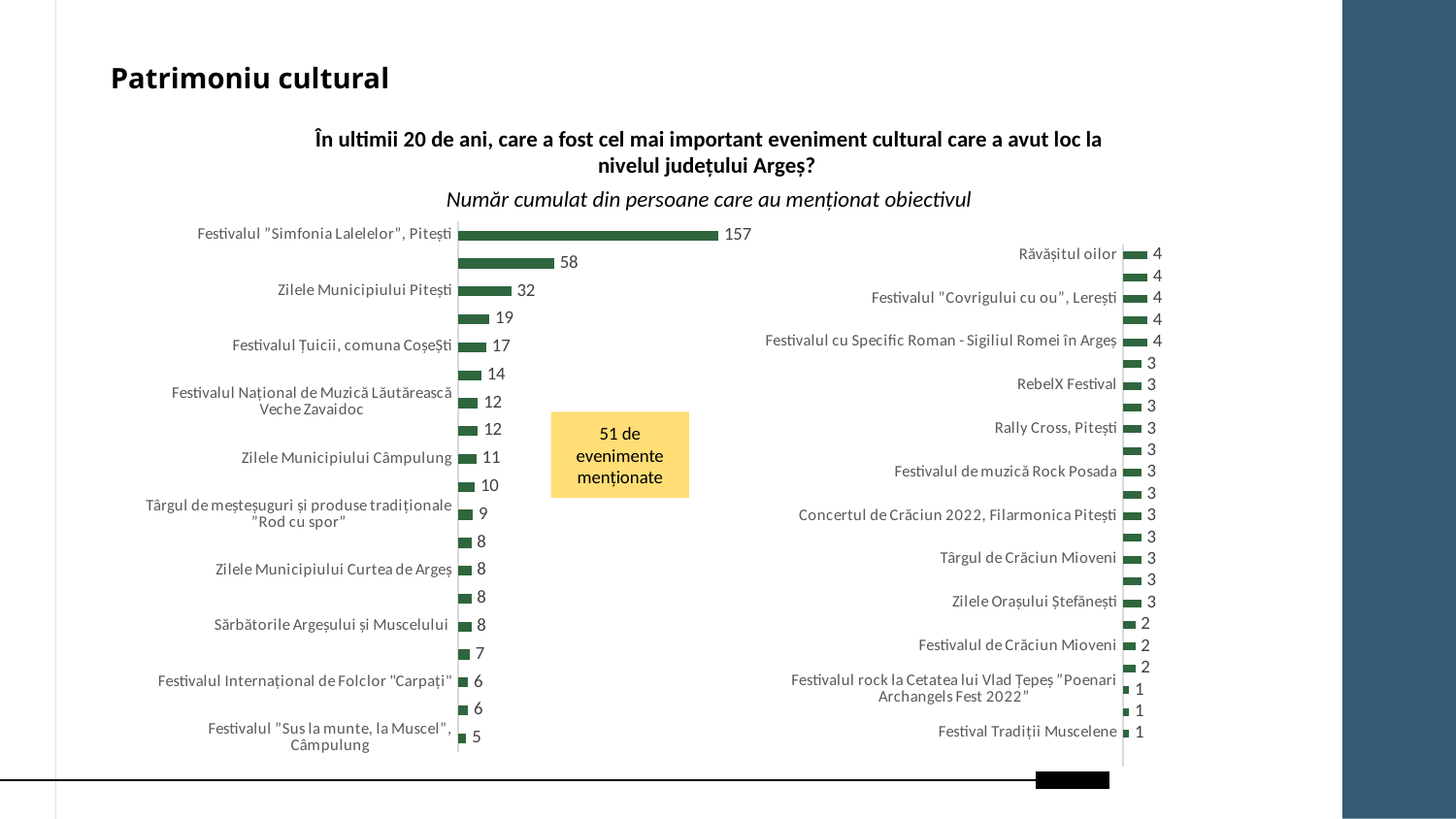
In the right chart, what is the value for Festivalul de Crăciun Mioveni? 2 In the left chart, which category has the highest value? Festivalul "Simfonia Lalelelor", Pitești In the left chart, what is the value for Festivalul Țuicii, comuna Coșești? 17 What kind of chart is shown on the left of the slide? Bar chart In the left chart, what is the value for Festivalul "Simfonia Lalelelor", Pitești? 157 In the left chart, what is the difference between the values for Festivalul "Simfonia Lalelelor", Pitești and Zilele Municipiului Pitești? 125 In the left chart, what is the value for Zilele Municipiului Pitești? 32 In the right chart, what is the value for Răvășitul oilor? 4 According to the yellow box on the slide, how many events were mentioned? 51 de evenimente menționate In the left chart, what is the value for Zilele Municipiului Câmpulung? 11 In the left chart, which is larger: the value for Festivalul Țuicii, comuna Coșești or the value for Zilele Municipiului Curtea de Argeș? Festivalul Țuicii, comuna Coșești In the right chart, what is the value for Festival Tradiții Muscelene? 1